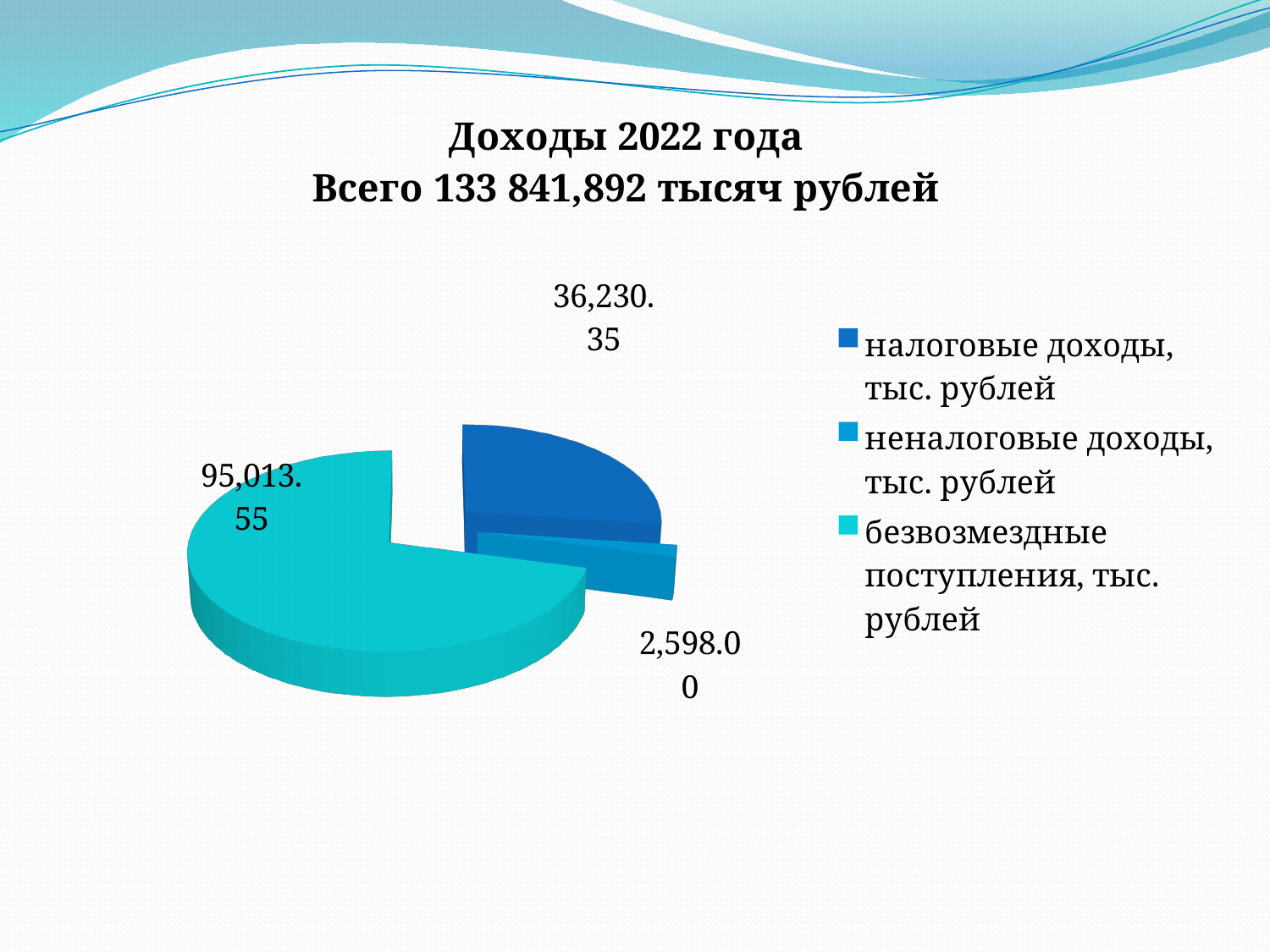
Which is larger: налоговые доходы or неналоговые доходы? налоговые доходы What is the difference between налоговые доходы and неналоговые доходы? 33,632.35 What is the value for налоговые доходы, тыс. рублей? 36,230.35 How many slices does the pie chart have? 3 What is the difference between безвозмездные поступления and налоговые доходы? 58,783.20 Which category has the smallest slice of the pie? неналоговые доходы, тыс. рублей What is the value for неналоговые доходы, тыс. рублей? 2,598.00 What is the value for безвозмездные поступления, тыс. рублей? 95,013.55 What total amount is stated in the chart title? 133 841,892 тысяч рублей Which category has the largest slice of the pie? безвозмездные поступления, тыс. рублей What type of chart is shown on the slide? Pie chart How many entries does the legend list? 3